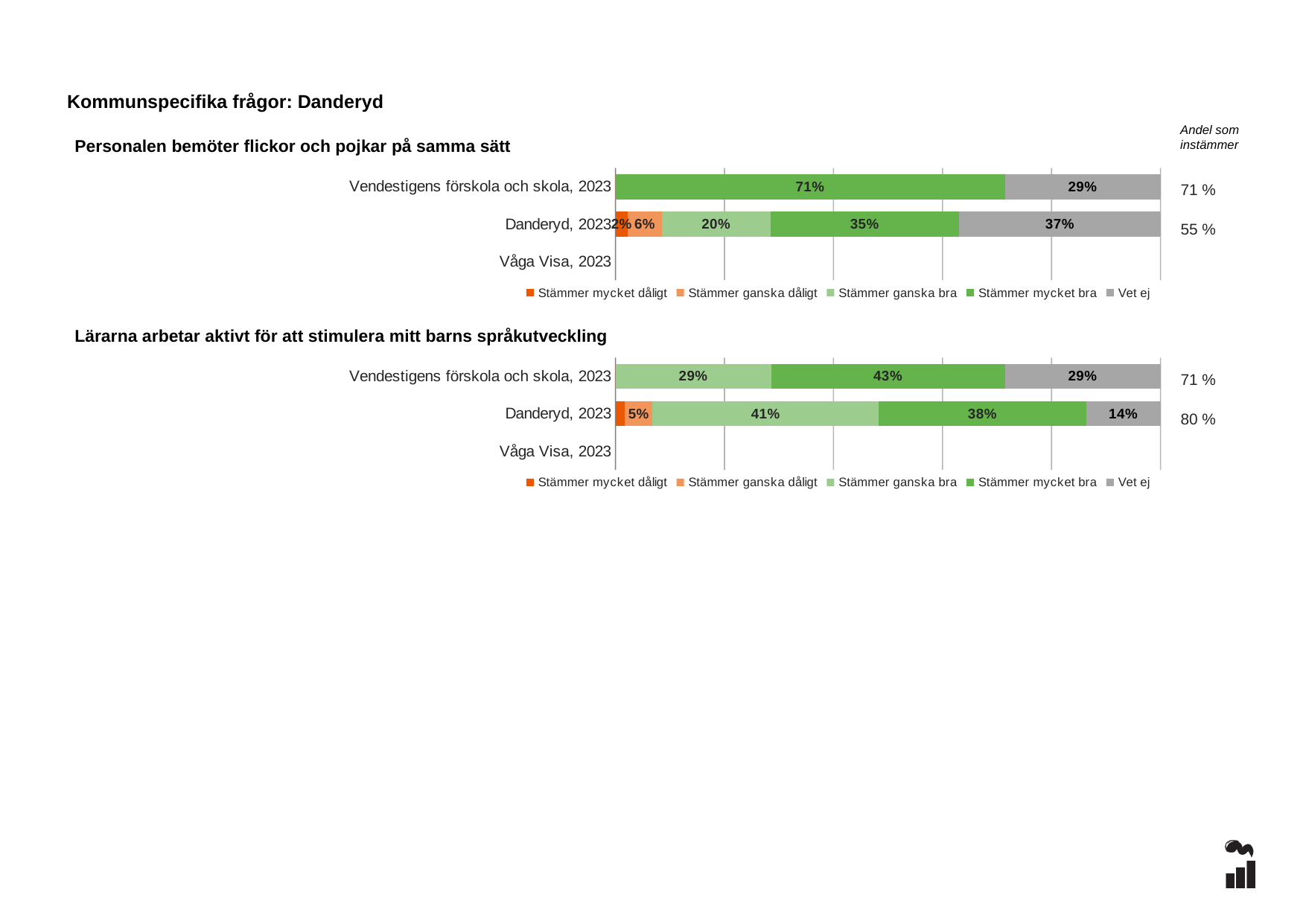
In the chart 'Personalen bemöter flickor och pojkar på samma sätt', what is the 'Vet ej' share for Danderyd, 2023? 37% In the chart 'Personalen bemöter flickor och pojkar på samma sätt', which is larger for Danderyd, 2023: 'Stämmer mycket bra' or 'Vet ej'? Vet ej In the chart 'Lärarna arbetar aktivt för att stimulera mitt barns språkutveckling', which row has the larger 'Stämmer mycket bra' share: Vendestigens förskola och skola, 2023 or Danderyd, 2023? Vendestigens förskola och skola, 2023 In the chart 'Lärarna arbetar aktivt för att stimulera mitt barns språkutveckling', what is the 'Stämmer ganska bra' share for Danderyd, 2023? 41% What kind of chart is 'Lärarna arbetar aktivt för att stimulera mitt barns språkutveckling'? Stacked bar chart In the chart 'Personalen bemöter flickor och pojkar på samma sätt', what percentage of Vendestigens förskola och skola, 2023 answered 'Stämmer mycket bra'? 71% In the chart 'Lärarna arbetar aktivt för att stimulera mitt barns språkutveckling', what is the 'Stämmer mycket bra' share for Vendestigens förskola och skola, 2023? 43% In the chart 'Lärarna arbetar aktivt för att stimulera mitt barns språkutveckling', what is the difference between the 'Vet ej' shares of Vendestigens förskola och skola, 2023 and Danderyd, 2023? 15 percentage points How many series does the legend of the chart 'Personalen bemöter flickor och pojkar på samma sätt' list? 5 In the chart 'Lärarna arbetar aktivt för att stimulera mitt barns språkutveckling', what is the 'Andel som instämmer' value shown for Danderyd, 2023? 80 % In the chart 'Personalen bemöter flickor och pojkar på samma sätt', what is the 'Stämmer ganska bra' share for Danderyd, 2023? 20% In the chart 'Personalen bemöter flickor och pojkar på samma sätt', what is the 'Andel som instämmer' value shown for Danderyd, 2023? 55 %